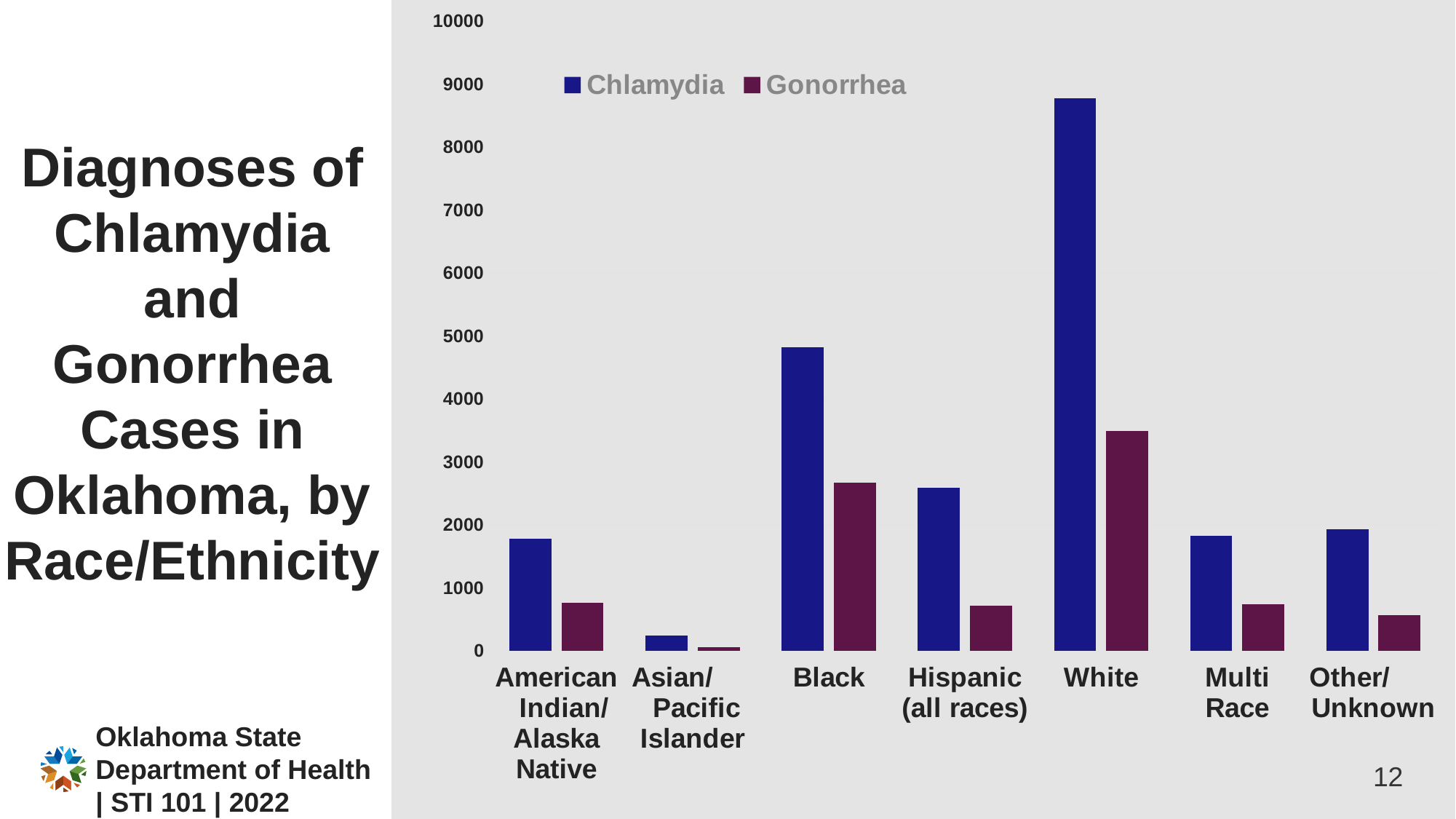
Which race/ethnicity category has the lowest number of Gonorrhea cases? Asian/Pacific Islander Which has more Chlamydia cases, Black or Hispanic (all races)? Black Is the Chlamydia value for Asian/Pacific Islander greater or less than 1000? less Is the Gonorrhea value for White greater or less than 3000? greater Is the Chlamydia value for White greater or less than 8000? greater Which race/ethnicity category has the highest number of Chlamydia cases? White Which race/ethnicity category has the highest number of Gonorrhea cases? White Which series is shown in dark blue in the legend? Chlamydia How many series does the legend list? 2 How many race/ethnicity categories are shown on the x axis? 7 What kind of chart is shown on the slide? Bar chart